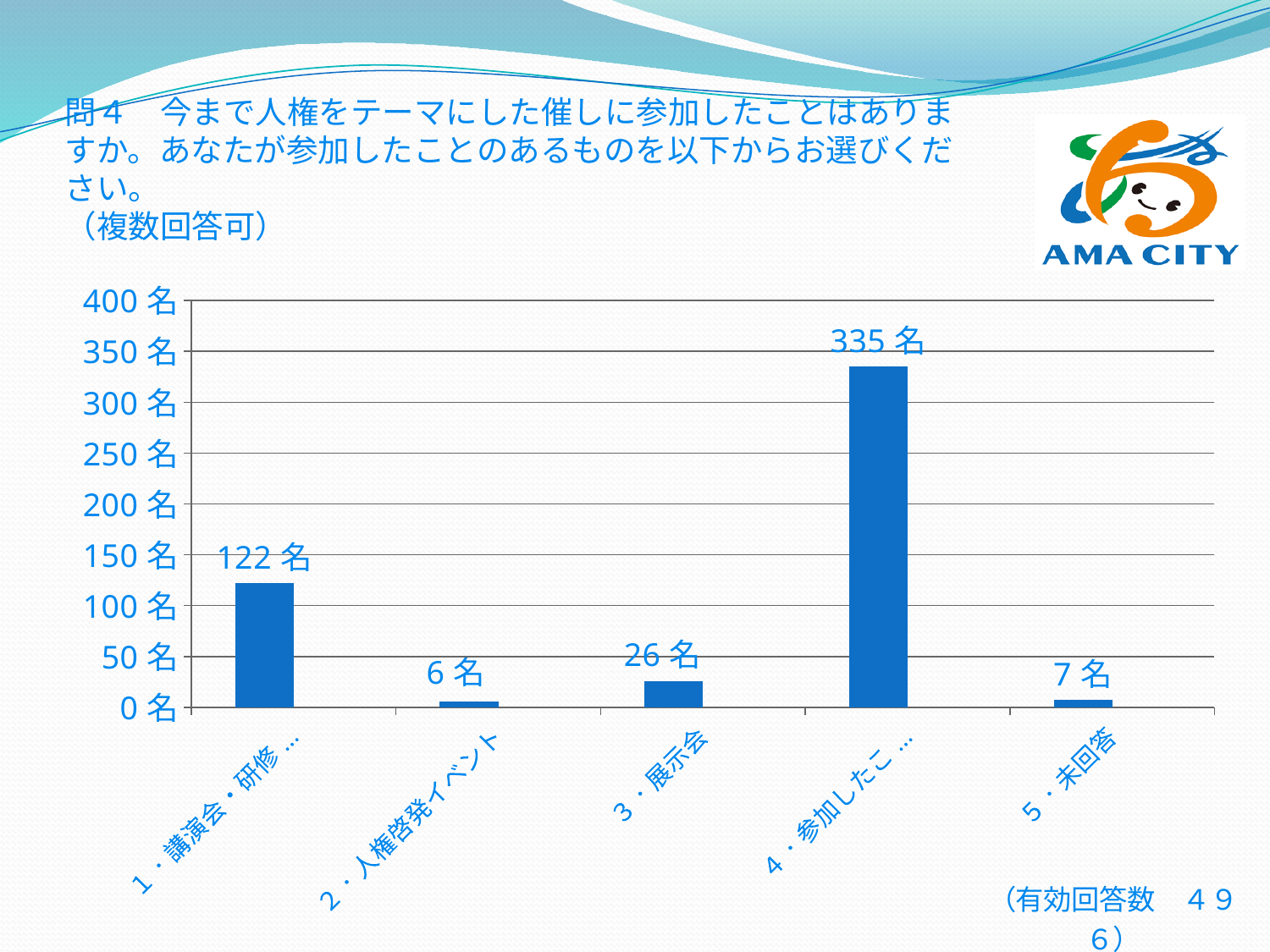
How many categories are plotted in the chart? 5 Which is larger, the value for 3・展示会 or the value for 5・未回答? 3・展示会 Which category has the highest value? 4・参加したこ… Which category has the lowest value? 2・人権啓発イベント What is the value for 5・未回答? 7 名 What is the value for 3・展示会? 26 名 What is the value for 2・人権啓発イベント? 6 名 What is the difference between the value for the fourth category (4・参加したこ…) and the first category (1・講演会・研修…)? 213 名 What is the value for the fourth category (4・参加したこ…)? 335 名 What is the value for the first category (1・講演会・研修…)? 122 名 Is the value for the first category (1・講演会・研修…) greater or less than 100 名? greater What kind of chart is shown on the slide? bar chart